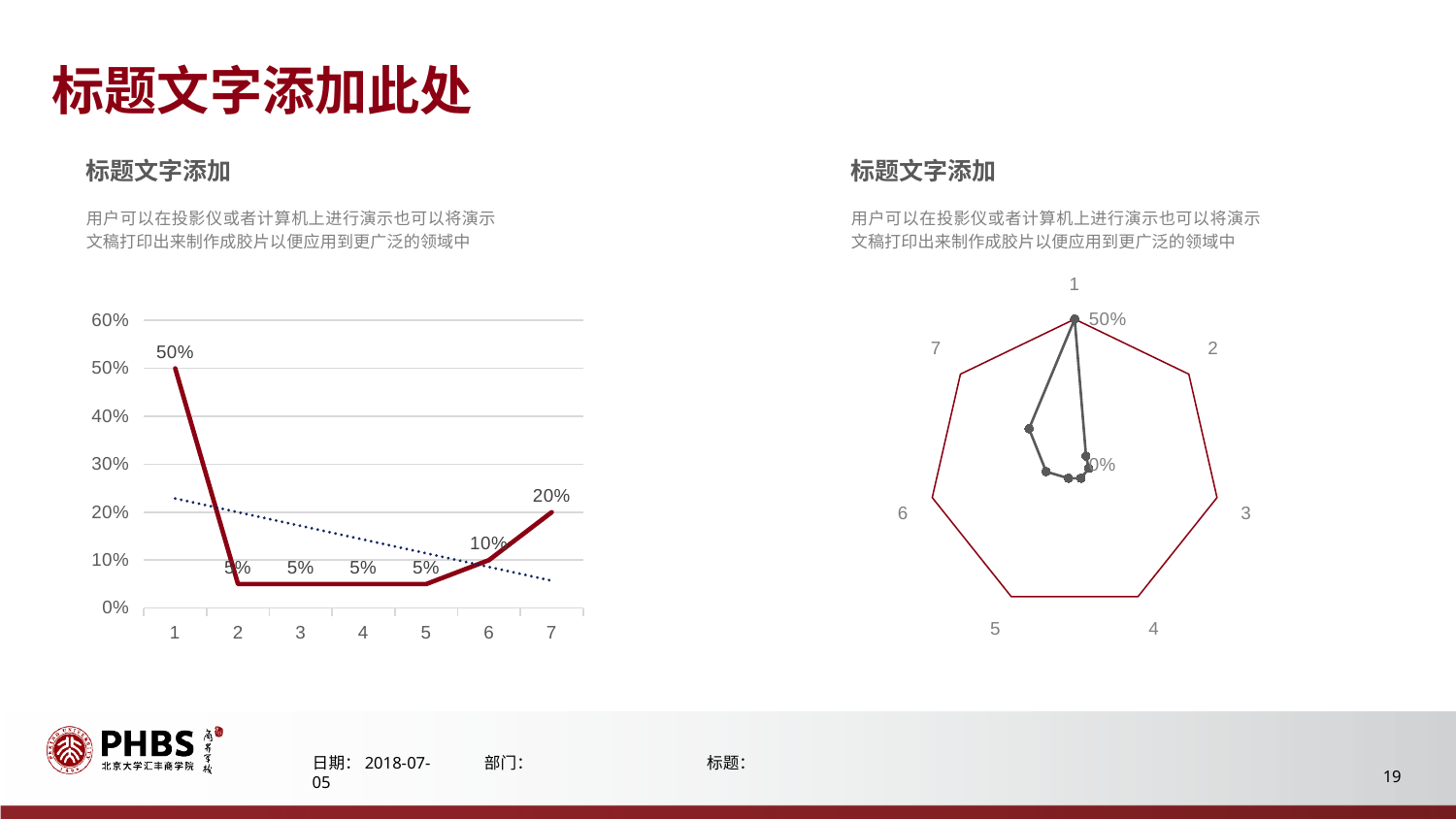
On the left line chart, do the values rise or fall from category 1 to category 2? fall What kind of chart is shown on the right side of the slide? radar chart On the left line chart, what is the value for category 6? 10% On the right radar chart, how many axes (categories) are there? 7 On the left line chart, how many categories are shown on the x axis? 7 On the left line chart, what is the value for category 1? 50% On the left line chart, what is the value for category 7? 20% On the right radar chart, what value is labelled at category 1? 50% On the left line chart, what is the difference between the values for category 1 and category 7? 30% On the left line chart, which is larger, the value for category 6 or the value for category 7? category 7 On the left line chart, is the value for category 1 greater or less than 40%? greater On the left line chart, which category has the highest value? 1